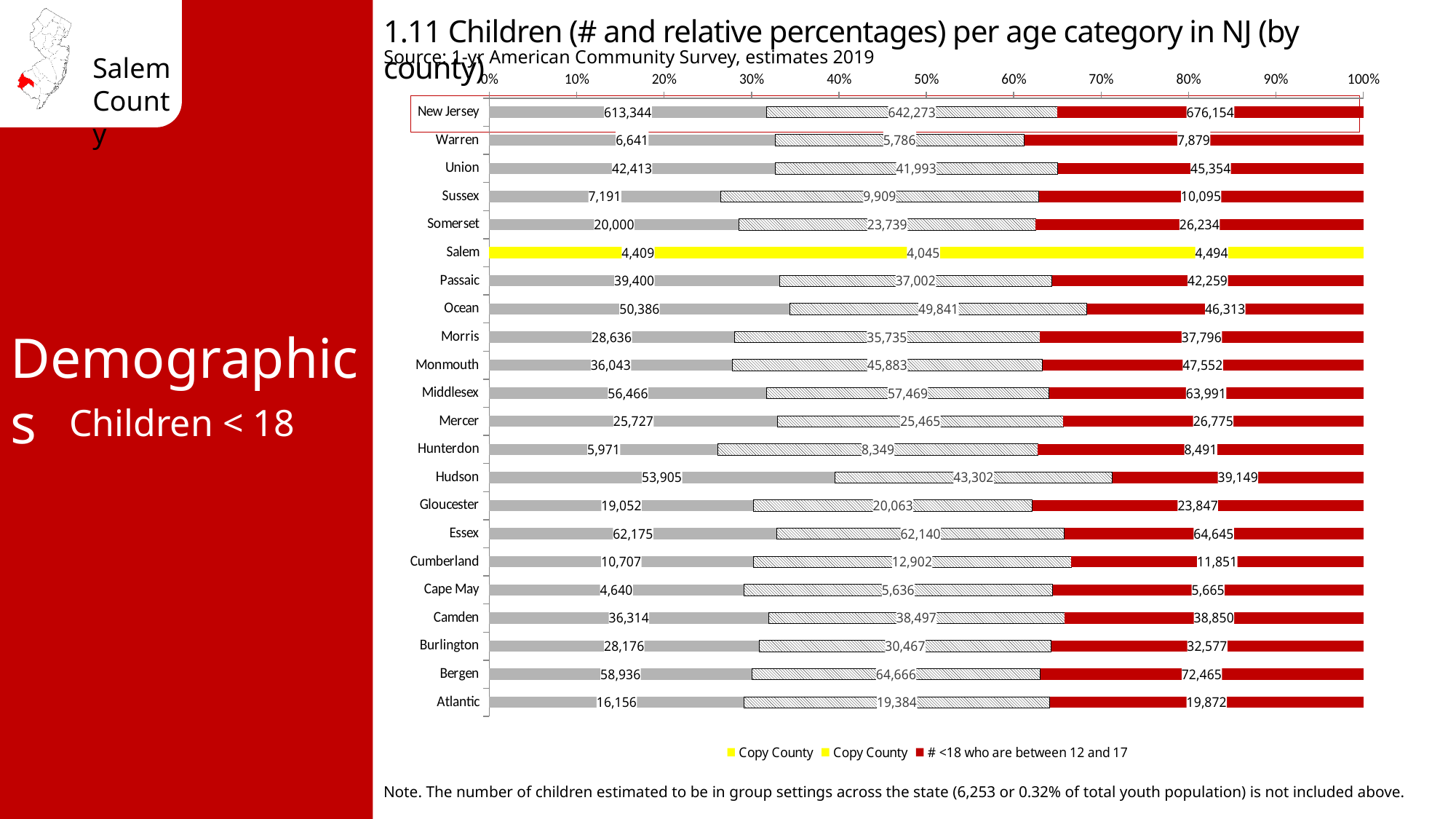
How many rows (categories) are plotted on the chart? 22 What is the value of the '# <18 who are between 12 and 17' segment for Bergen? 72,465 What kind of chart is shown on the slide? bar chart What is the total of the three segments for Salem? 12,948 What is the difference between the first segment (53,905) and the '# <18 who are between 12 and 17' segment (39,149) for Hudson? 14,756 Which county has the lowest value for '# <18 who are between 12 and 17'? Salem Is the share of the first (leftmost) segment for Hudson greater or less than 30%? greater What is the value of the middle segment for New Jersey? 642,273 What is the value of the first (leftmost) segment for Hudson? 53,905 Among the counties (excluding the New Jersey row), which has the highest value for '# <18 who are between 12 and 17'? Bergen What is the value of the '# <18 who are between 12 and 17' segment for Salem? 4,494 How many series does the legend list? 3